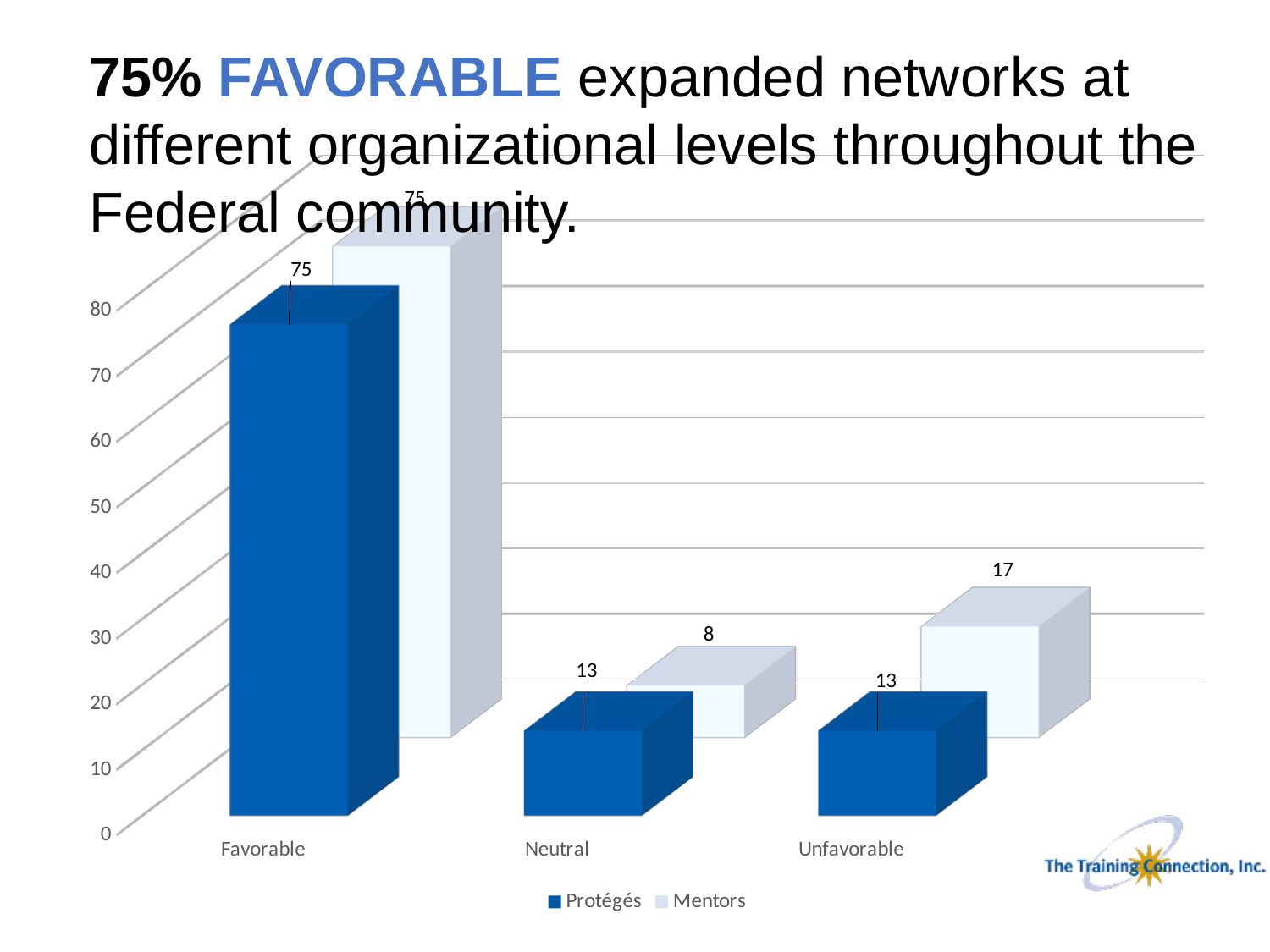
What is the value for Mentors in the Unfavorable category? 17 What is the difference between the Protégés values for Favorable and Neutral? 62 What is the value for Mentors in the Neutral category? 8 Which category has the lowest value for Mentors? Neutral In the Neutral category, which series has the larger value, Protégés or Mentors? Protégés What is the value for Protégés in the Favorable category? 75 What is the value for Protégés in the Unfavorable category? 13 Which category has the highest value for Protégés? Favorable How many categories are shown on the x axis? 3 What is the difference between the Mentors values for Unfavorable and Neutral? 9 How many series does the legend list? 2 What kind of chart is shown on the slide? Bar chart